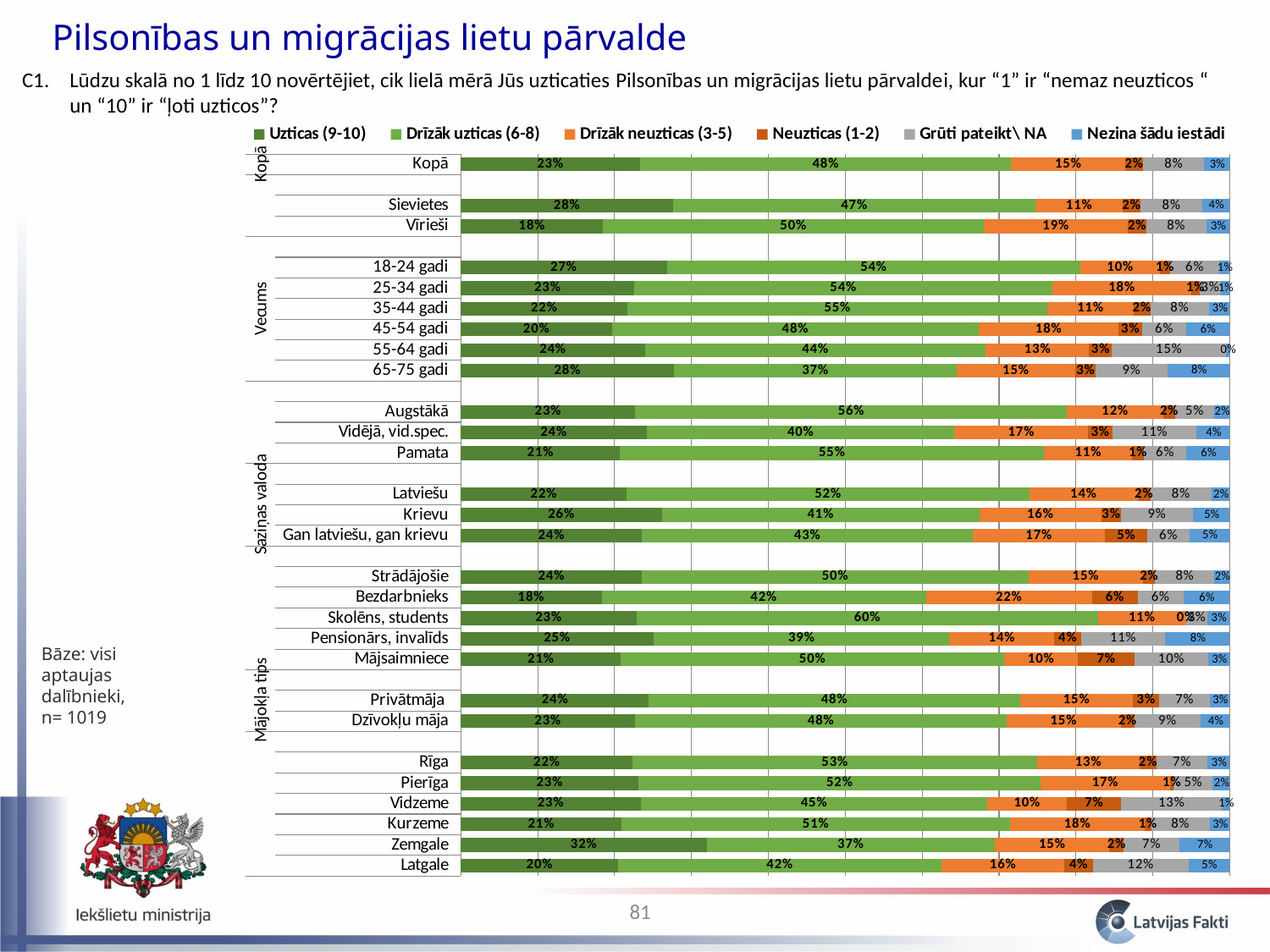
What is the value of "Nezina šādu iestādi" for 65-75 gadi? 8% How many categories (bars) are plotted in the chart? 28 What is the value of "Grūti pateikt\ NA" for Latgale? 12% What is the value of "Drīzāk neuzticas (3-5)" for Bezdarbnieks? 22% How many series does the legend list? 6 What is the value of "Uzticas (9-10)" for Kopā? 23% What is the difference between the "Uzticas (9-10)" values for Sievietes and Vīrieši? 10% Which category has the highest value for "Drīzāk uzticas (6-8)"? Skolēns, students Which category has the highest value for "Uzticas (9-10)"? Zemgale What is the value of "Drīzāk uzticas (6-8)" for Vīrieši? 50% What type of chart is shown on the slide? Stacked bar chart Which is larger, the "Drīzāk uzticas (6-8)" value for Zemgale or for Latgale? Latgale